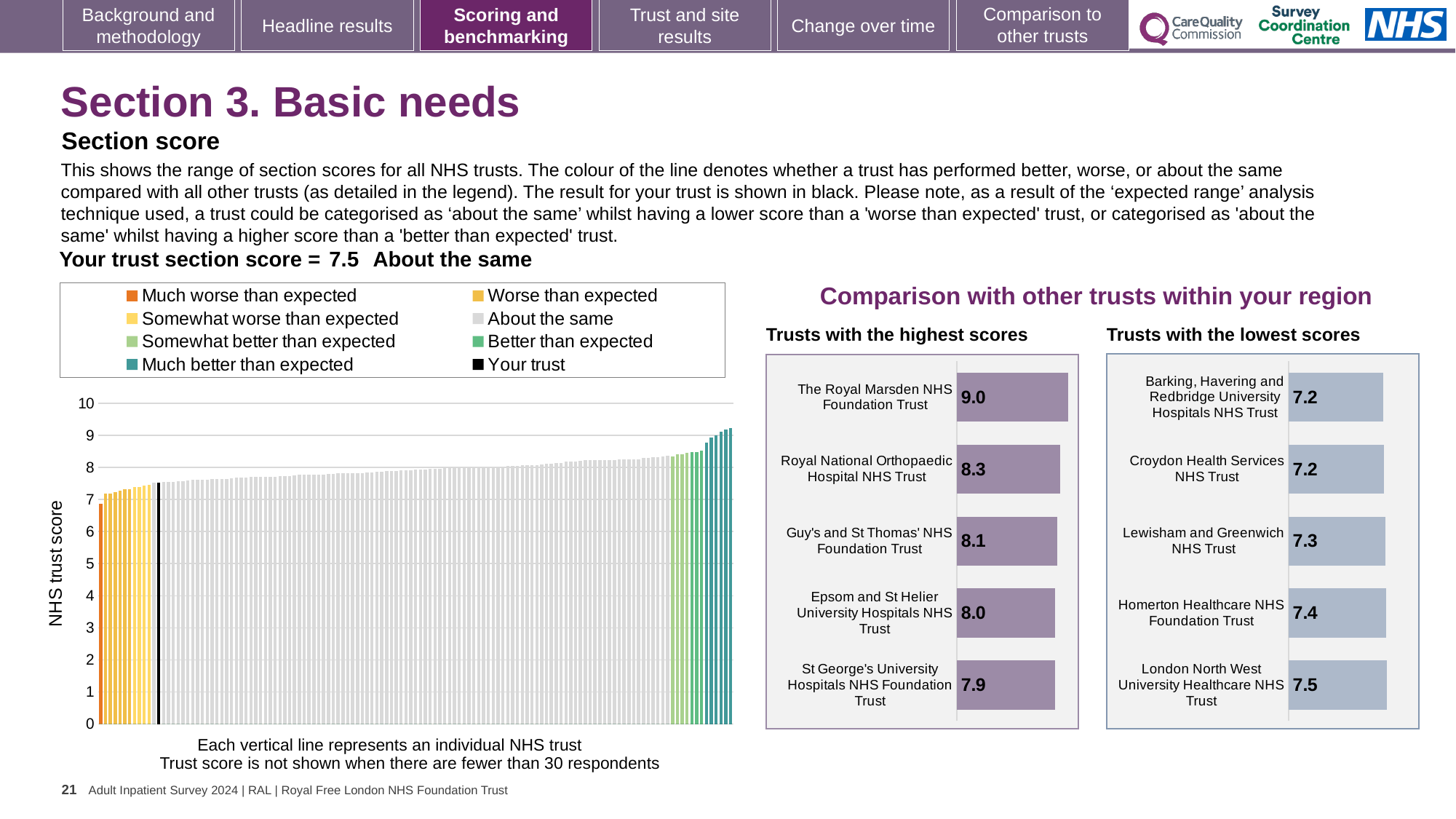
In the 'Trusts with the lowest scores' chart, what is the difference between the scores of London North West University Healthcare NHS Trust and Croydon Health Services NHS Trust? 0.3 In the NHS trust score chart on the left, do the values rise or fall from left to right? Rise In the 'Trusts with the highest scores' chart, which has the larger score: Royal National Orthopaedic Hospital NHS Trust or Epsom and St Helier University Hospitals NHS Trust? Royal National Orthopaedic Hospital NHS Trust In the 'Trusts with the highest scores' chart, what is the score for The Royal Marsden NHS Foundation Trust? 9.0 In the 'Trusts with the highest scores' chart, which trust has the highest score? The Royal Marsden NHS Foundation Trust How many trusts are listed in the 'Trusts with the lowest scores' chart? 5 In the 'Trusts with the lowest scores' chart, which trust has the highest score shown? London North West University Healthcare NHS Trust What kind of chart is the NHS trust score chart on the left of the slide? Bar chart How many entries does the legend of the NHS trust score chart on the left list? 8 In the 'Trusts with the highest scores' chart, what is the score for Guy's and St Thomas' NHS Foundation Trust? 8.1 In the 'Trusts with the lowest scores' chart, what is the score for Homerton Healthcare NHS Foundation Trust? 7.4 In the 'Trusts with the highest scores' chart, what is the difference between the scores of The Royal Marsden NHS Foundation Trust and St George's University Hospitals NHS Foundation Trust? 1.1